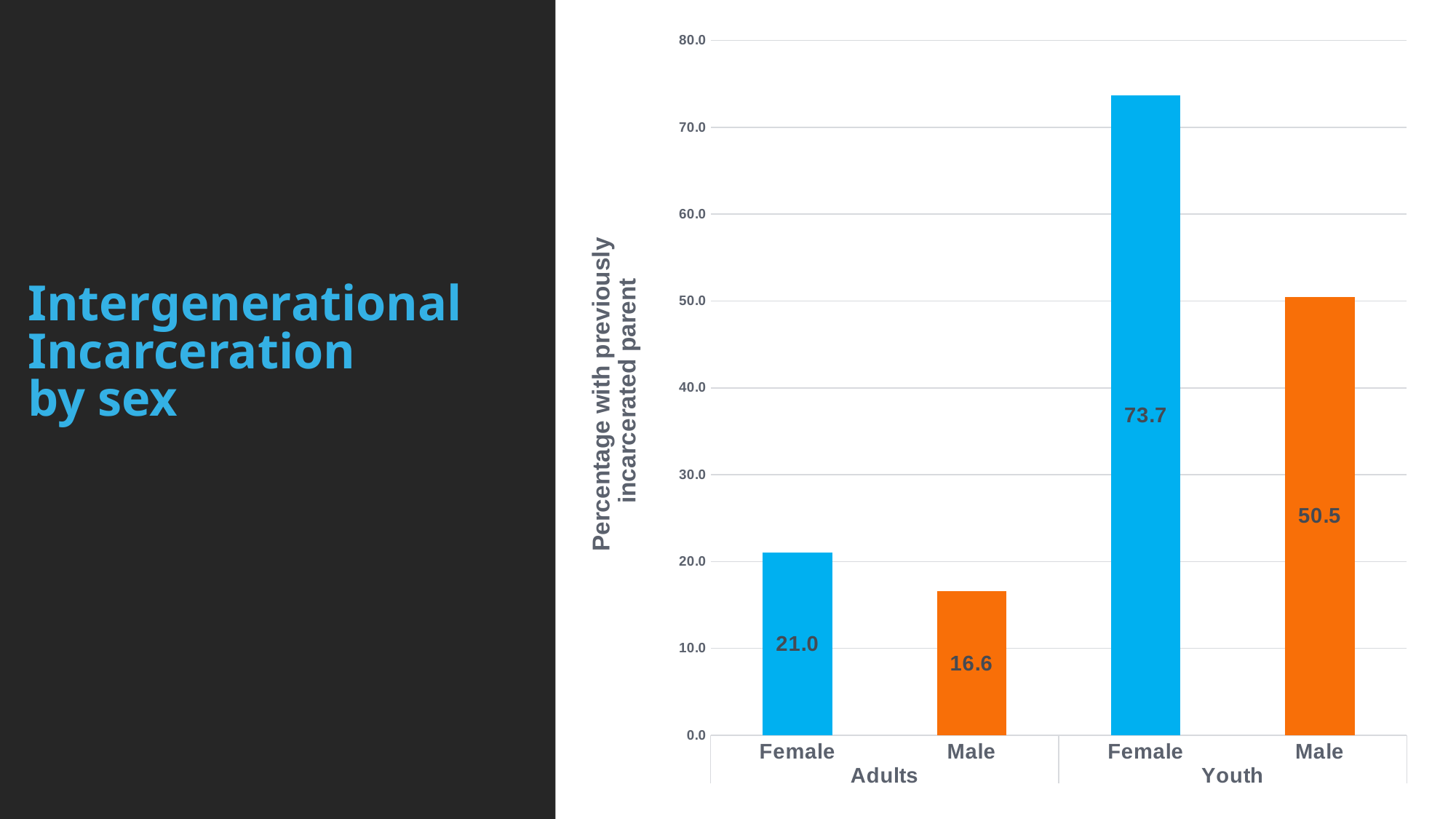
What kind of chart is shown on the slide? Bar chart How many bars are plotted in the chart? 4 What is the value for Male in the Youth group? 50.5 What is the value for Female in the Adults group? 21.0 Which bar has the lowest value? Adults Male What is the value for Male in the Adults group? 16.6 Which is larger, the Adults Female value or the Youth Male value? Youth Male What is the value for Female in the Youth group? 73.7 What is the difference between the Adults Female and Adults Male values? 4.4 What is the label on the vertical axis? Percentage with previously incarcerated parent What is the difference between the Youth Female and Youth Male values? 23.2 Which bar has the highest value? Youth Female